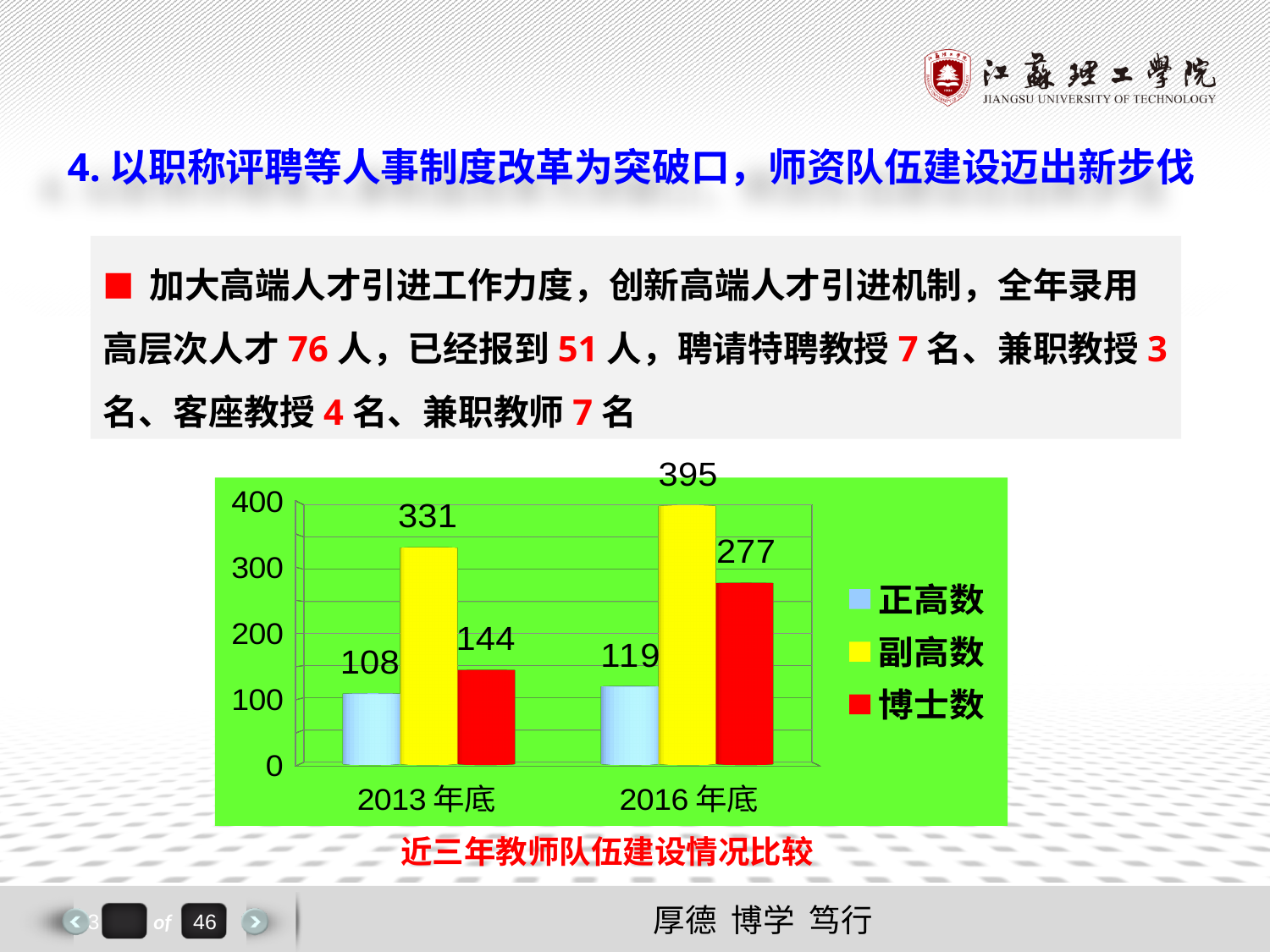
Which series has the highest value at 2016年底? 副高数 What is the value of 副高数 at 2013年底? 331 Does the value of 正高数 rise or fall from 2013年底 to 2016年底? rise Which series has the lowest value at 2013年底? 正高数 What is the difference between 副高数 at 2016年底 and 副高数 at 2013年底? 64 What is the value of 博士数 at 2016年底? 277 Which is larger: 博士数 at 2013年底 or 正高数 at 2013年底? 博士数 at 2013年底 How many series does the legend list? 3 What is the difference between 博士数 at 2016年底 and 博士数 at 2013年底? 133 How many categories are shown on the x axis? 2 What is the value of 正高数 at 2016年底? 119 What kind of chart is shown on the slide? bar chart